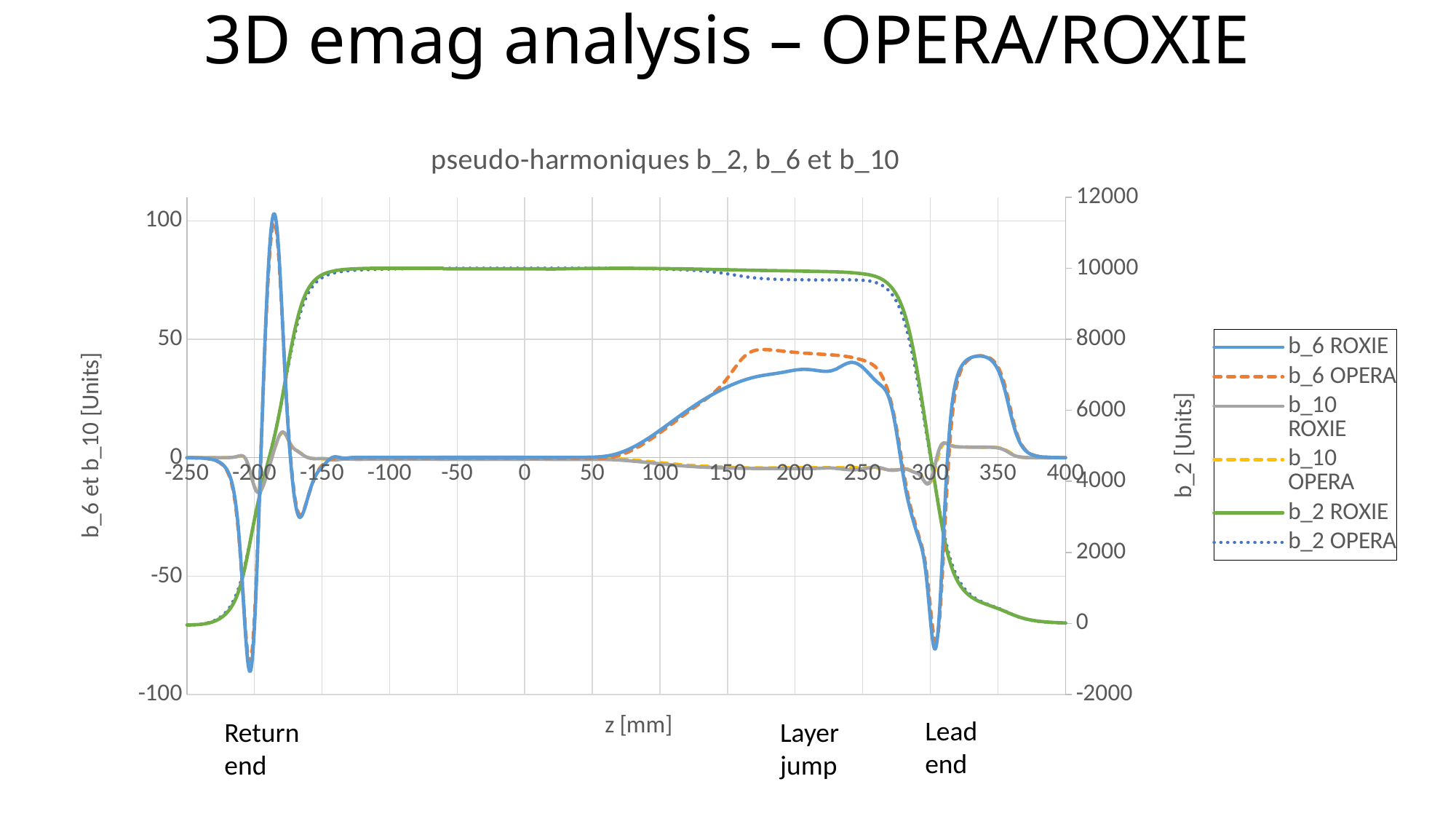
What is the label of the x axis? z [mm] At z = 175, which is larger: b_6 OPERA or b_6 ROXIE? b_6 OPERA What is the title of the chart? pseudo-harmoniques b_2, b_6 et b_10 Is the minimum value of b_6 ROXIE near z = -200 greater or less than -50? less How many series does the legend list? 6 Does b_6 ROXIE rise or fall between z = 50 and z = 200? rise Is the value of b_2 ROXIE at z = 400 greater or less than 2000? less Is the value of b_2 ROXIE at z = 0 greater or less than 8000? greater Which series is plotted against the right-hand axis labelled b_2 [Units] and drawn as a solid green line? b_2 ROXIE What kind of chart is shown on the slide? line chart Does b_2 ROXIE rise or fall between z = 250 and z = 350? fall